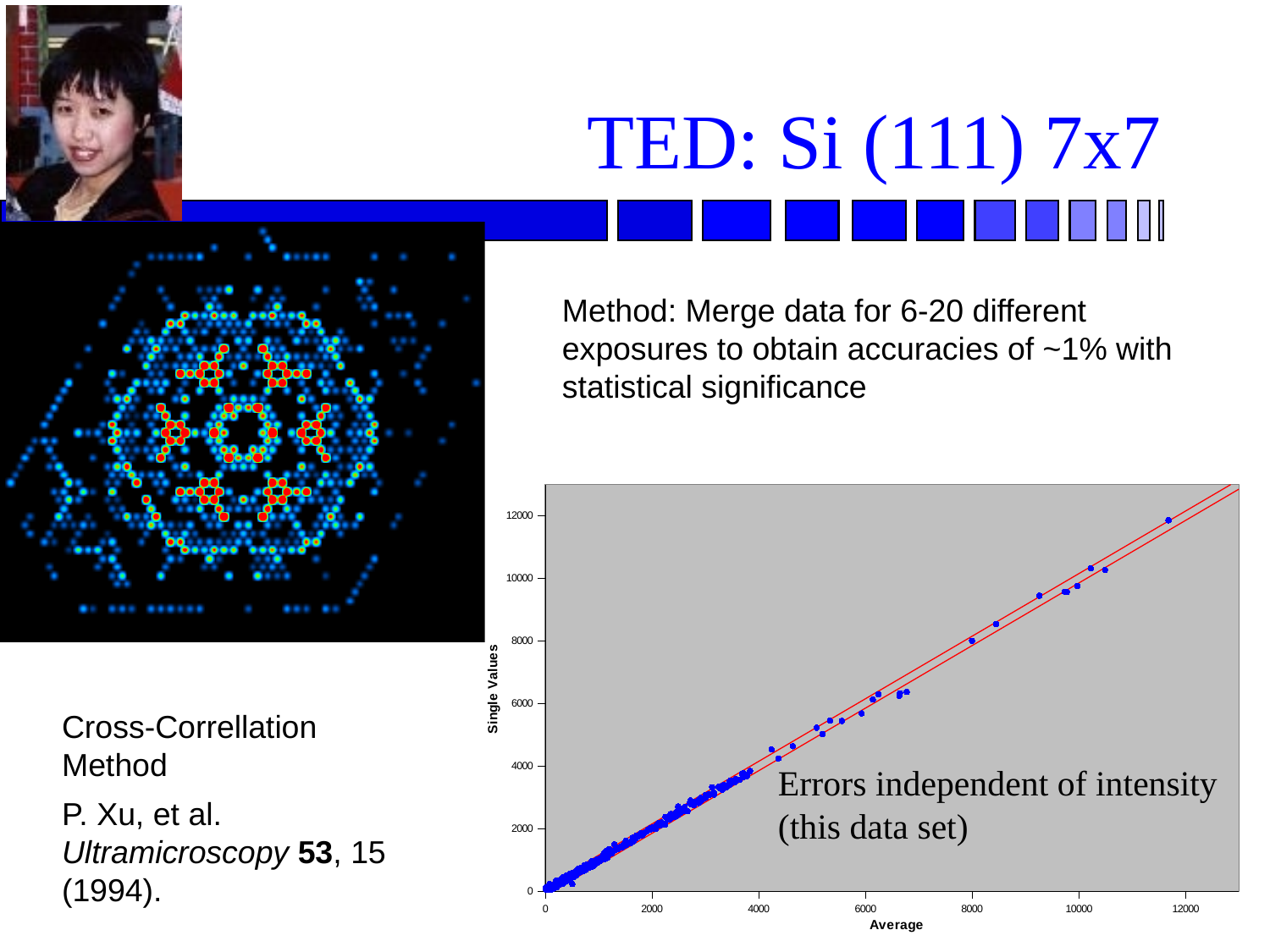
Is the Average of the rightmost data point greater or less than 10000? greater What kind of chart is shown on the slide? scatter plot Is the Single Values reading for the point with the largest Average greater or less than 10000? greater What is the title of the x axis of the scatter plot? Average Do the Single Values rise or fall as Average increases along the x axis? rise What is the title of the y axis of the scatter plot? Single Values Are most of the data points in the scatter plot located below or above an Average of 4000? below What is the highest tick value labelled on the y axis of the scatter plot? 12000